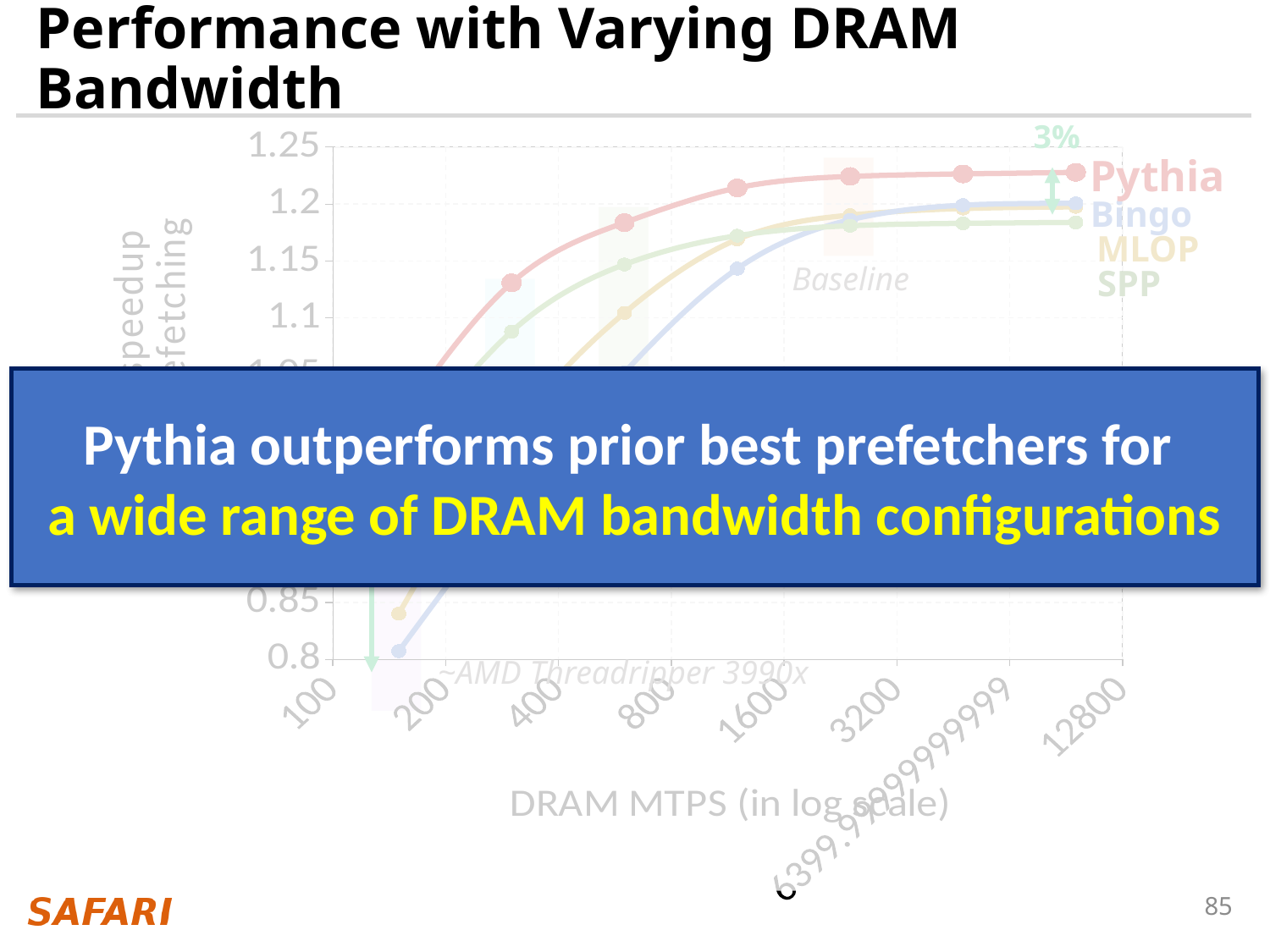
Is the value for Bingo at 200 DRAM MTPS greater or less than 0.85? less Is the value for SPP at 12800 DRAM MTPS greater or less than 1.2? less How many series (prefetchers) are plotted in the chart? 4 Is the value for Pythia at 400 DRAM MTPS greater or less than 1.1? greater Which series has the lowest speedup at 200 DRAM MTPS? Bingo Which series has the highest speedup at 12800 DRAM MTPS? Pythia What is the label of the x axis of the chart? DRAM MTPS (in log scale) At 400 DRAM MTPS, which series has the higher speedup, Pythia or SPP? Pythia Does the speedup of Pythia rise or fall as DRAM MTPS increases along the x axis? rise What kind of chart is shown on the slide? line chart What percentage is annotated at the right end of the chart between the Pythia and Bingo lines? 3%